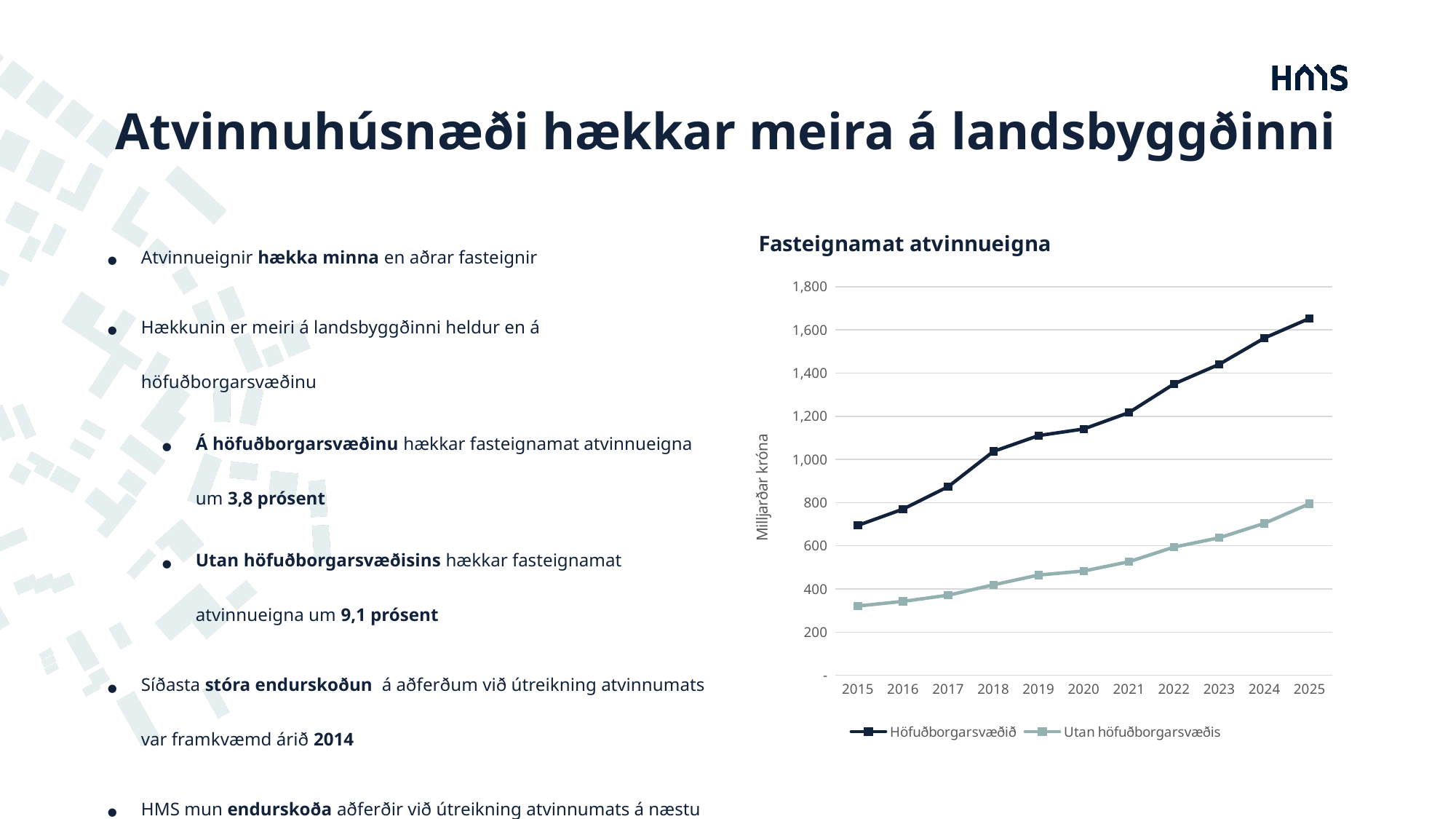
Is the value for Utan höfuðborgarsvæðis in 2020 greater or less than 400? greater How many series does the chart legend list? 2 What is the label of the y axis of the chart? Milljarðar króna Is the value for Höfuðborgarsvæðið in 2015 greater or less than 800? less Is the value for Utan höfuðborgarsvæðis in 2015 greater or less than 400? less Which series has the larger value in 2025, Höfuðborgarsvæðið or Utan höfuðborgarsvæðis? Höfuðborgarsvæðið What kind of chart is shown on the slide? line chart How many years are shown on the x axis of the chart? 11 What is the title of the chart? Fasteignamat atvinnueigna Do the values for Utan höfuðborgarsvæðis rise or fall from 2015 to 2025? rise